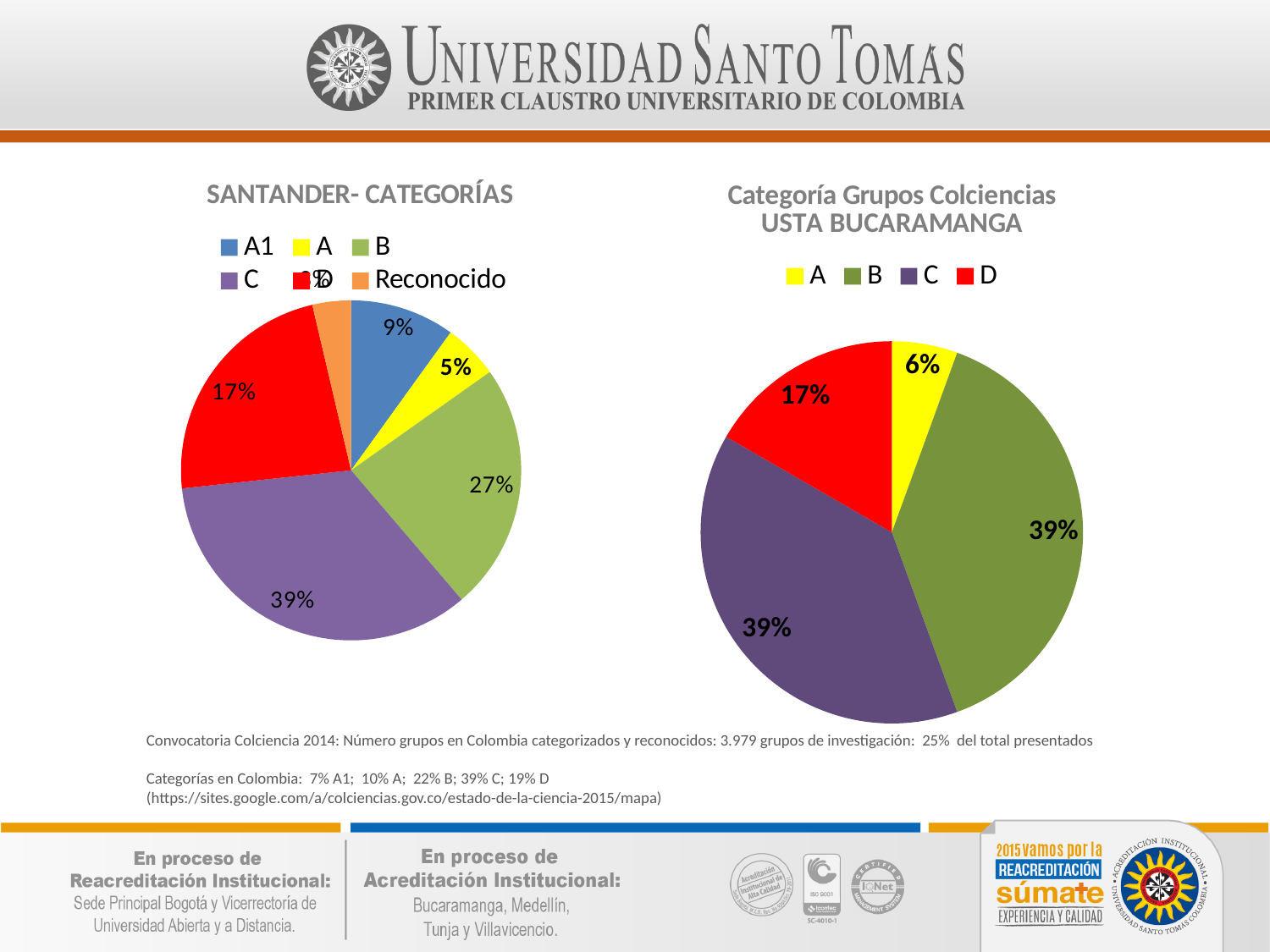
In the Categoría Grupos Colciencias USTA BUCARAMANGA chart, what share does category A have? 6% In the SANTANDER- CATEGORÍAS chart, what share does category B have? 27% In the Categoría Grupos Colciencias USTA BUCARAMANGA chart, which category has the smallest share? A In the Categoría Grupos Colciencias USTA BUCARAMANGA chart, what share does category D have? 17% How many categories does the legend of the SANTANDER- CATEGORÍAS chart list? 6 What type of chart is the Categoría Grupos Colciencias USTA BUCARAMANGA chart? Pie chart In the SANTANDER- CATEGORÍAS chart, what share does category A1 have? 9% In the SANTANDER- CATEGORÍAS chart, what share does category C have? 39% In the SANTANDER- CATEGORÍAS chart, which category has the largest share? C In the Categoría Grupos Colciencias USTA BUCARAMANGA chart, what is the difference between the shares of category B and category D? 22% In the SANTANDER- CATEGORÍAS chart, what is the difference between the shares of category D and category A? 12% In the SANTANDER- CATEGORÍAS chart, which is larger, the share of B or the share of D? B